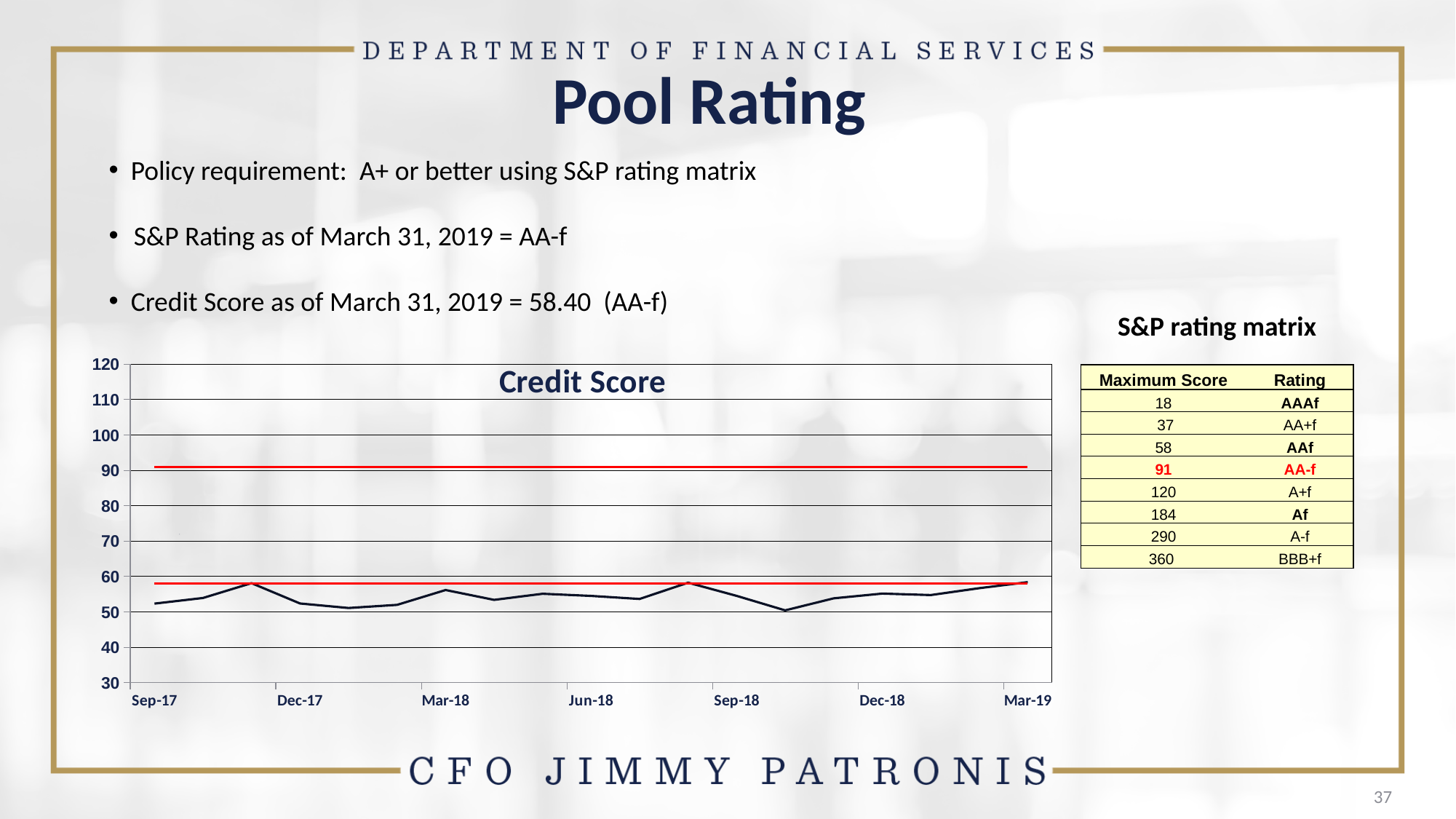
What is the highest value shown on the y axis of the Credit Score chart? 120 How many date labels are shown on the x axis of the Credit Score chart? 7 What kind of chart is the Credit Score chart? line chart Is the credit score value for Mar-18 greater or less than 50? greater Is the credit score value for Mar-19 greater or less than 50? greater Which has the higher credit score, Sep-17 or Mar-19? Mar-19 What is the title of the chart on the slide? Credit Score Is the credit score value for Jun-18 greater or less than 70? less